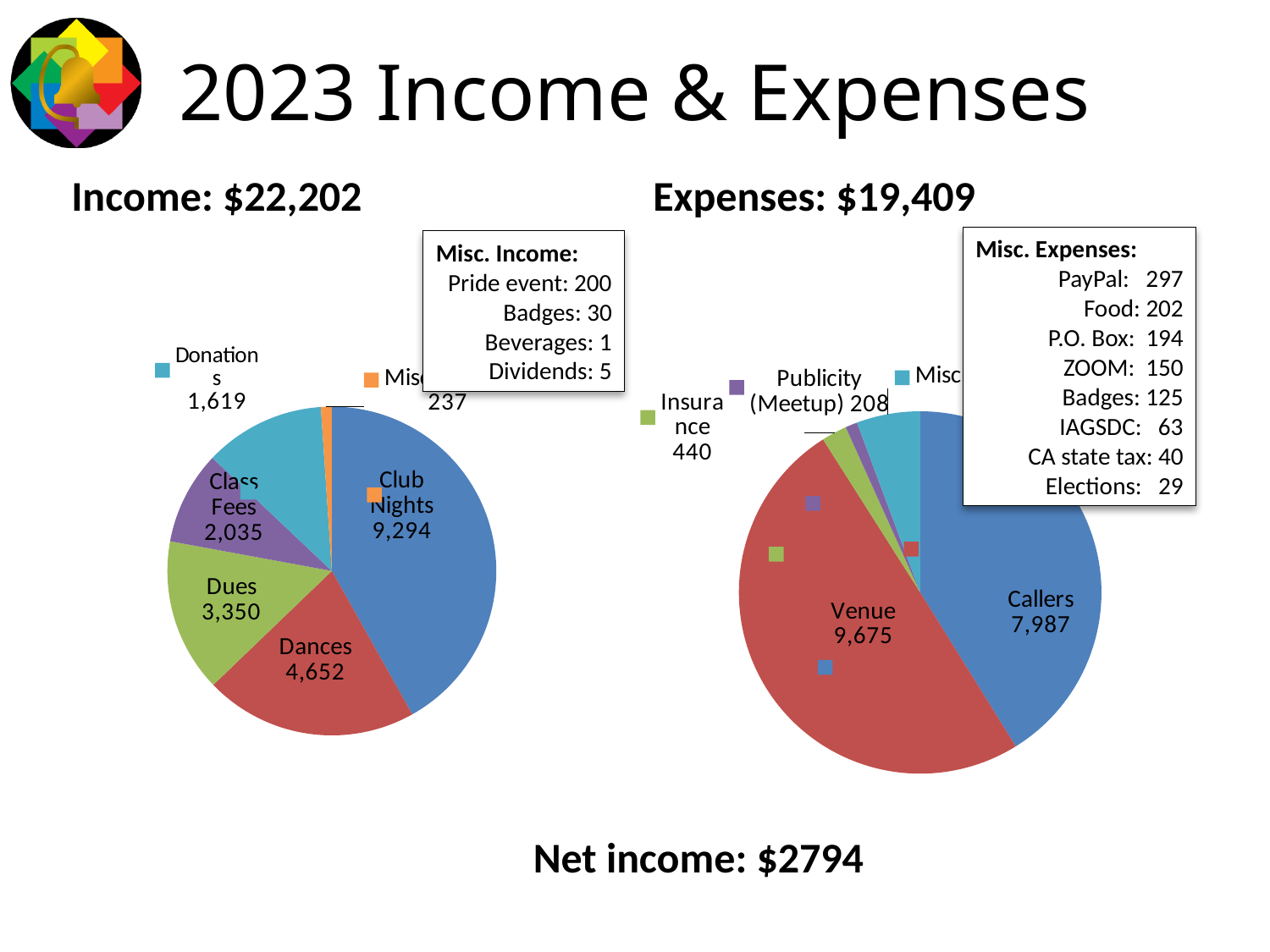
In the Income pie chart, which category has the largest value? Club Nights In the Income pie chart, how many categories are shown? 6 What type of chart is used for the Income chart on the left? pie chart In the Expenses pie chart, what is the value for Venue? 9,675 In the Expenses pie chart, what is the value for Insurance? 440 In the Income pie chart, what is the difference between Dances and Dues? 1,302 In the Expenses pie chart, what is the difference between Venue and Callers? 1,688 In the Income pie chart, which category has the smallest value? Misc In the Income pie chart, what is the value for Club Nights? 9,294 In the Income pie chart, what is the value for Dues? 3,350 What total is shown in the heading above the Expenses pie chart? $19,409 In the Expenses pie chart, which is larger, Venue or Callers? Venue